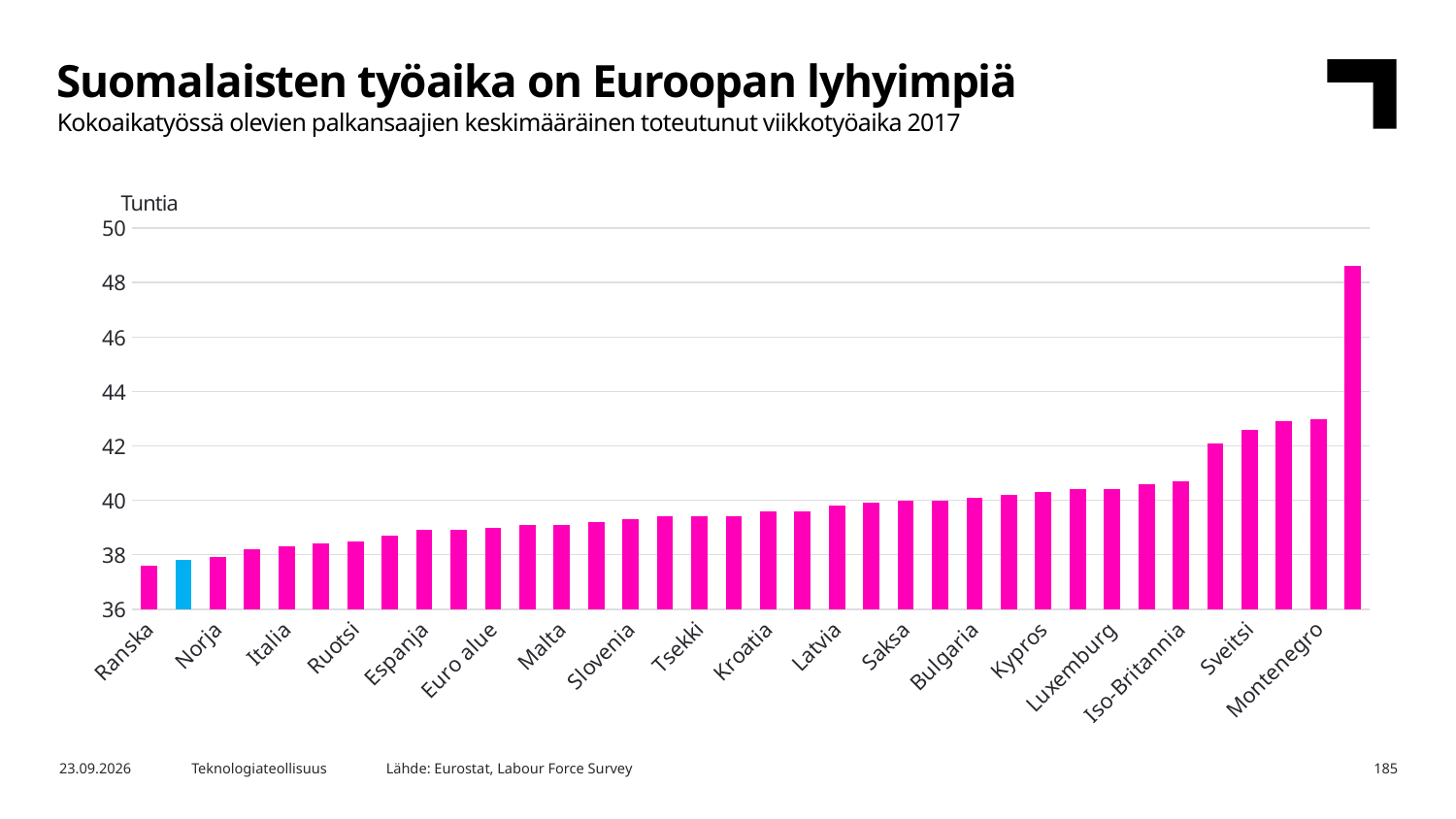
Is the value for Malta greater or less than 40? less Is the value for Espanja greater or less than 40? less Is the value for Iso-Britannia greater or less than 40? greater What colour is the bar that is highlighted differently from the others? blue Which has the larger value, Malta or Luxemburg? Luxemburg What unit is shown on the y axis of the chart? Tuntia Do the values rise or fall from left to right along the x axis? rise What kind of chart is shown on the slide? bar chart Which has the larger value, Ranska or Montenegro? Montenegro